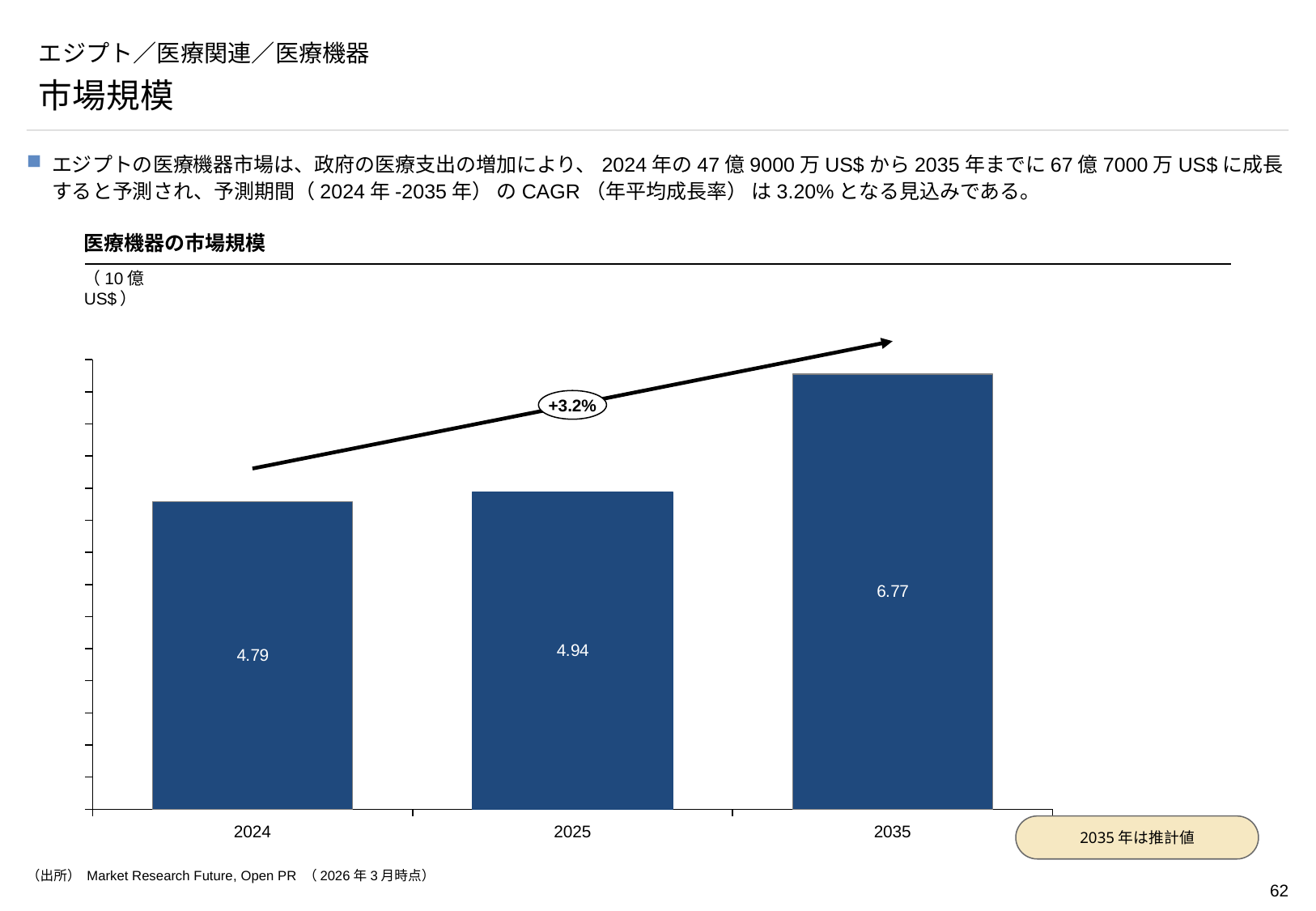
What growth rate is shown in the label on the arrow above the bars? +3.2% What is the value for 2025? 4.94 Which year has the lowest value? 2024 Do the values rise or fall from 2024 to 2035? Rise Which is larger, the value for 2025 or the value for 2035? 2035 How many years are shown on the x axis? 3 Which year has the highest value? 2035 What kind of chart is this? Bar chart What is the difference between the values for 2035 and 2024? 1.98 What is the value for 2024? 4.79 What is the difference between the values for 2025 and 2024? 0.15 What is the value for 2035? 6.77